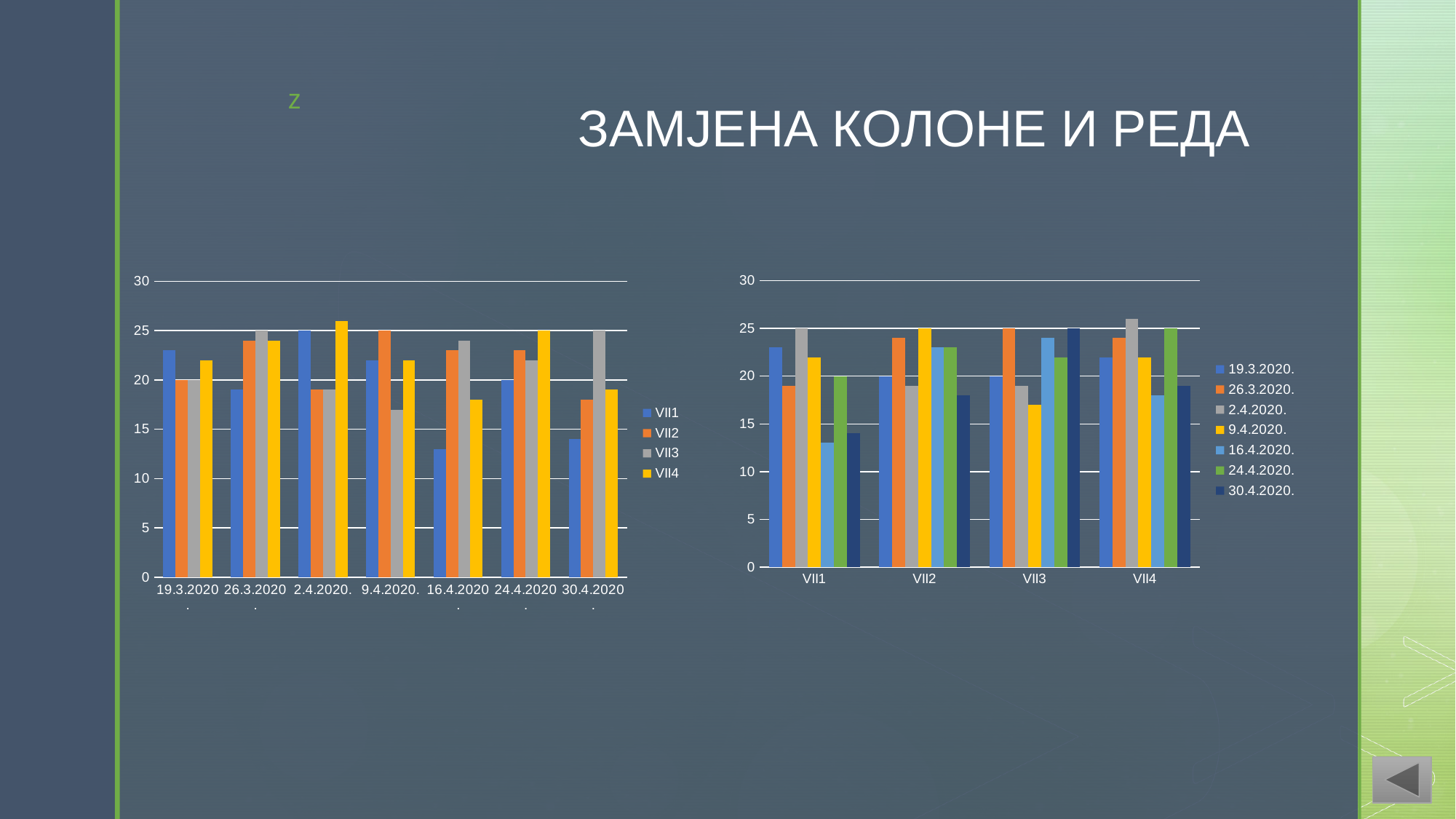
How many date categories are shown on the x axis of the left chart? 7 In the left chart, which series has the lowest value for 9.4.2020? VII3 In the left chart, is the value of VII1 for 16.4.2020 greater or less than 15? less In the right chart, is the value of 30.4.2020. for VII2 greater or less than 20? less How many categories are shown on the x axis of the right chart? 4 What kind of chart is the chart on the left of the slide? bar chart In the right chart, for VII2, which is larger: 26.3.2020. or 2.4.2020.? 26.3.2020. In the left chart, which series has the highest value for 30.4.2020? VII3 In the left chart, for 9.4.2020, which is larger: VII2 or VII3? VII2 How many series does the legend of the right chart list? 7 How many series does the legend of the left chart list? 4 In the left chart, which series has the lowest value for 16.4.2020? VII1